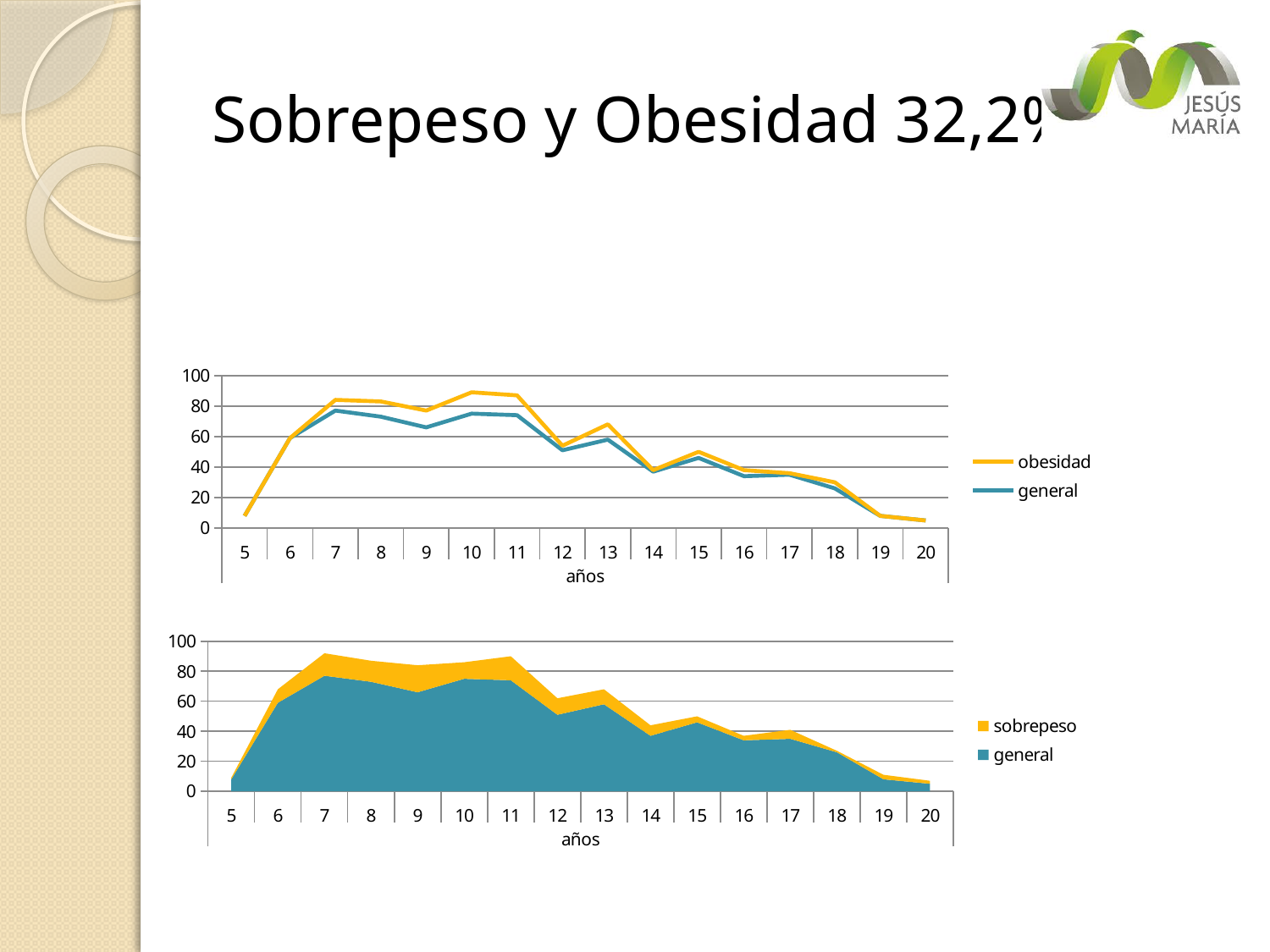
In the top chart, at age 13, which series has the higher value, obesidad or general? obesidad What is the x-axis title of the bottom chart? años In the top chart, do the values of the general series rise or fall from age 11 to age 20? fall What kind of chart is the bottom chart on the slide? area chart In the top chart, how many series does the legend list? 2 In the top chart, how many age categories are shown on the x axis? 16 In the top chart, is the value of general at age 16 greater or less than 40? less In the top chart, is the value of obesidad at age 10 greater or less than 80? greater In the bottom chart, is the value of general at age 7 greater or less than 60? greater What kind of chart is the top chart on the slide? line chart In the bottom chart, what are the two series named in the legend? sobrepeso and general